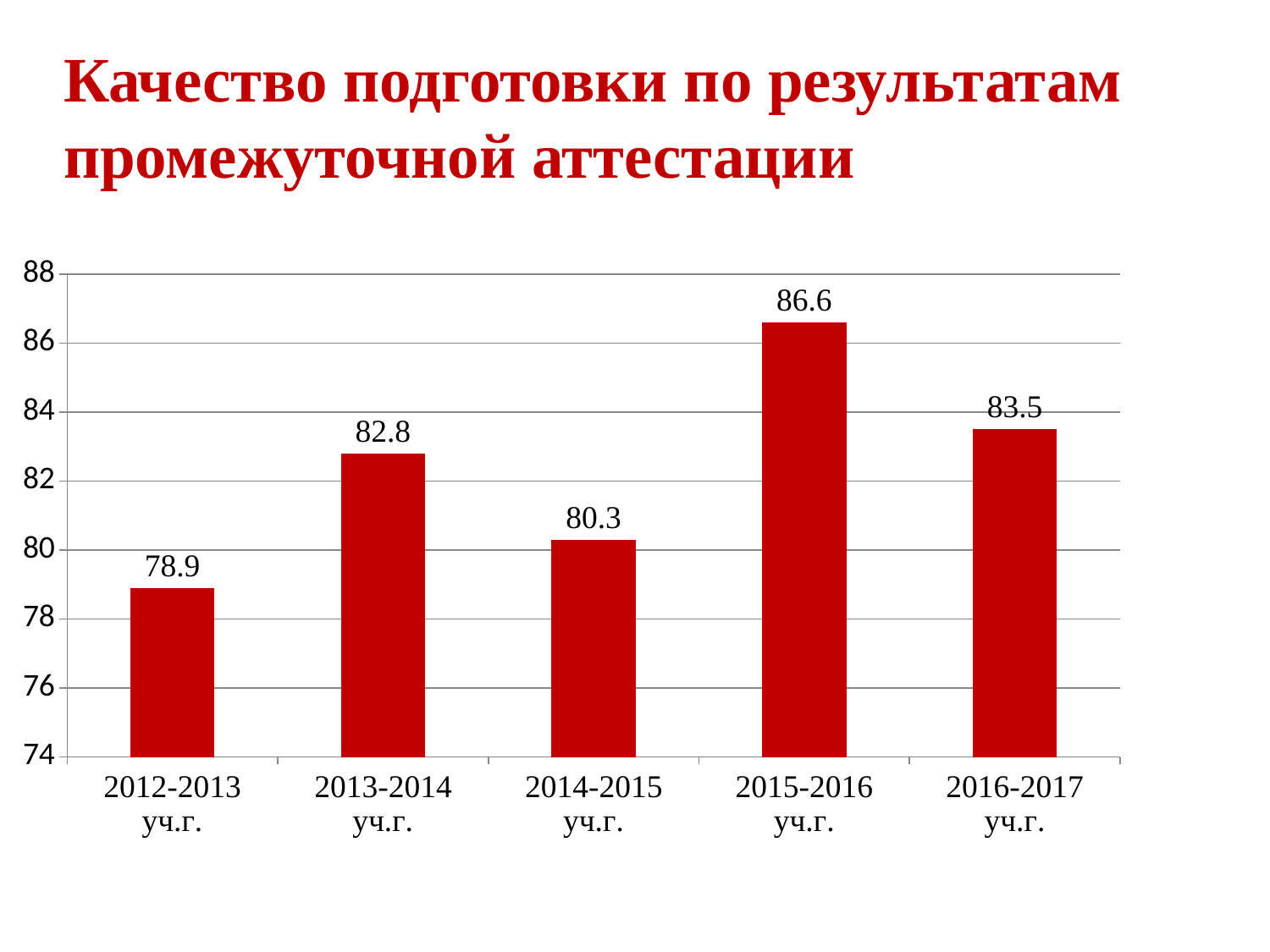
What is the value for 2015-2016 уч.г.? 86.6 What kind of chart is shown on the slide? bar chart What is the difference between the values for 2015-2016 уч.г. and 2014-2015 уч.г.? 6.3 Which is larger, the value for 2013-2014 уч.г. or 2014-2015 уч.г.? 2013-2014 уч.г. What is the value for 2016-2017 уч.г.? 83.5 Which academic year has the lowest value? 2012-2013 уч.г. What is the title of the slide? Качество подготовки по результатам промежуточной аттестации What is the difference between the values for 2013-2014 уч.г. and 2012-2013 уч.г.? 3.9 What is the value for 2012-2013 уч.г.? 78.9 Which academic year has the highest value? 2015-2016 уч.г. How many academic years are shown on the chart? 5 Is the value for 2016-2017 уч.г. greater or less than 82? greater